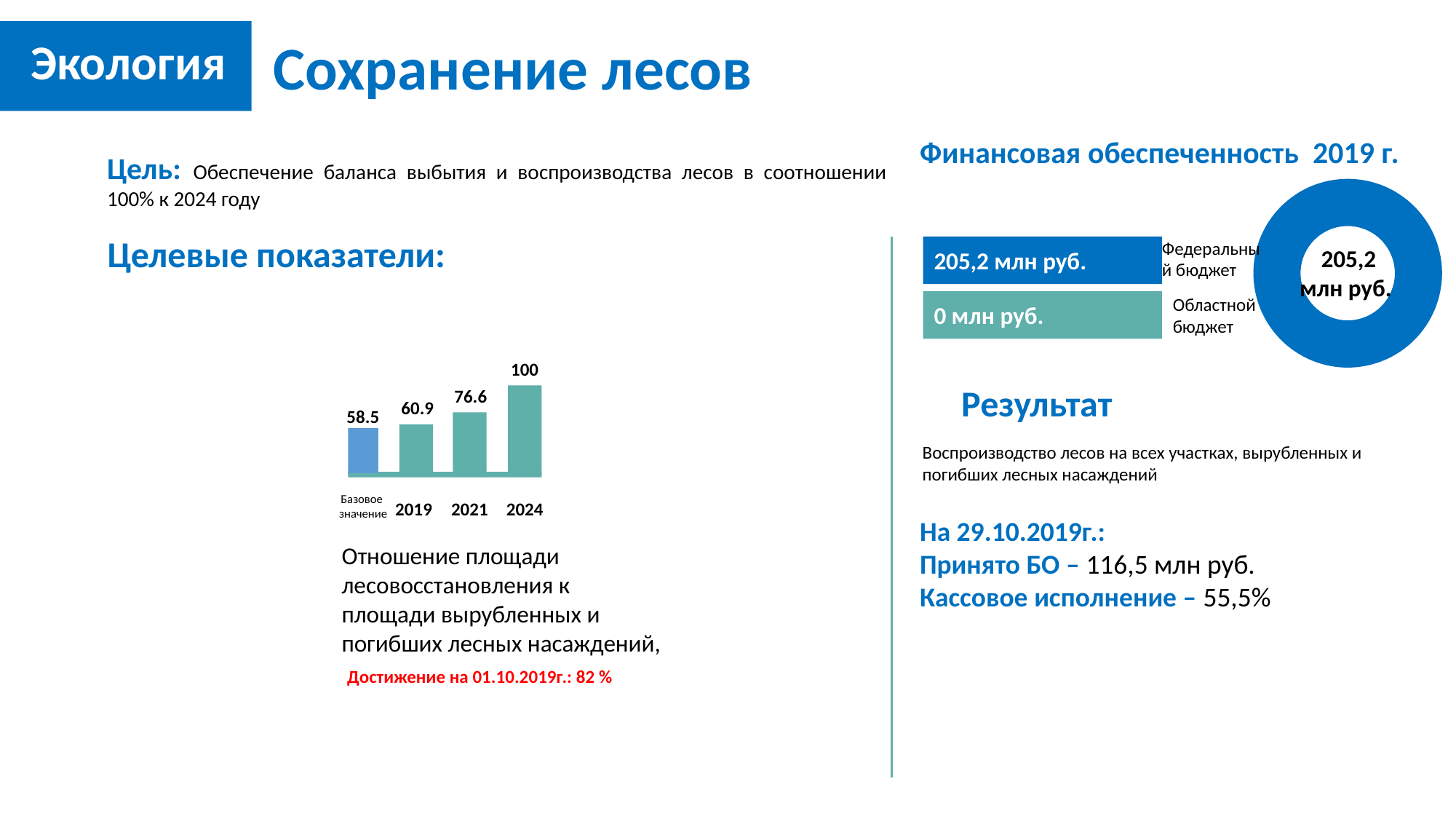
In the bar chart on the left under "Целевые показатели", what is the value for 2021? 76.6 In the bar chart on the left under "Целевые показатели", which category has the highest value? 2024 In the bar chart on the left under "Целевые показатели", which is larger: the value for 2021 or the value for 2019? 2021 How many bars are in the bar chart on the left under "Целевые показатели"? 4 In the bar chart on the left under "Целевые показатели", what is the value for 2024? 100 In the bar chart on the left under "Целевые показатели", do the values rise or fall from the base value to 2024? Rise In the donut chart under "Финансовая обеспеченность 2019 г.", what total value is printed in the centre? 205,2 млн руб. In the bar chart on the left under "Целевые показатели", what is the value for 2019? 60.9 In the bar chart on the left under "Целевые показатели", which category has the lowest value? Базовое значение In the bar chart on the left under "Целевые показатели", what is the value labelled "Базовое значение"? 58.5 In the bar chart on the left under "Целевые показатели", what is the difference between the 2024 value and the 2021 value? 23.4 What kind of chart is shown on the left under "Целевые показатели"? Bar chart